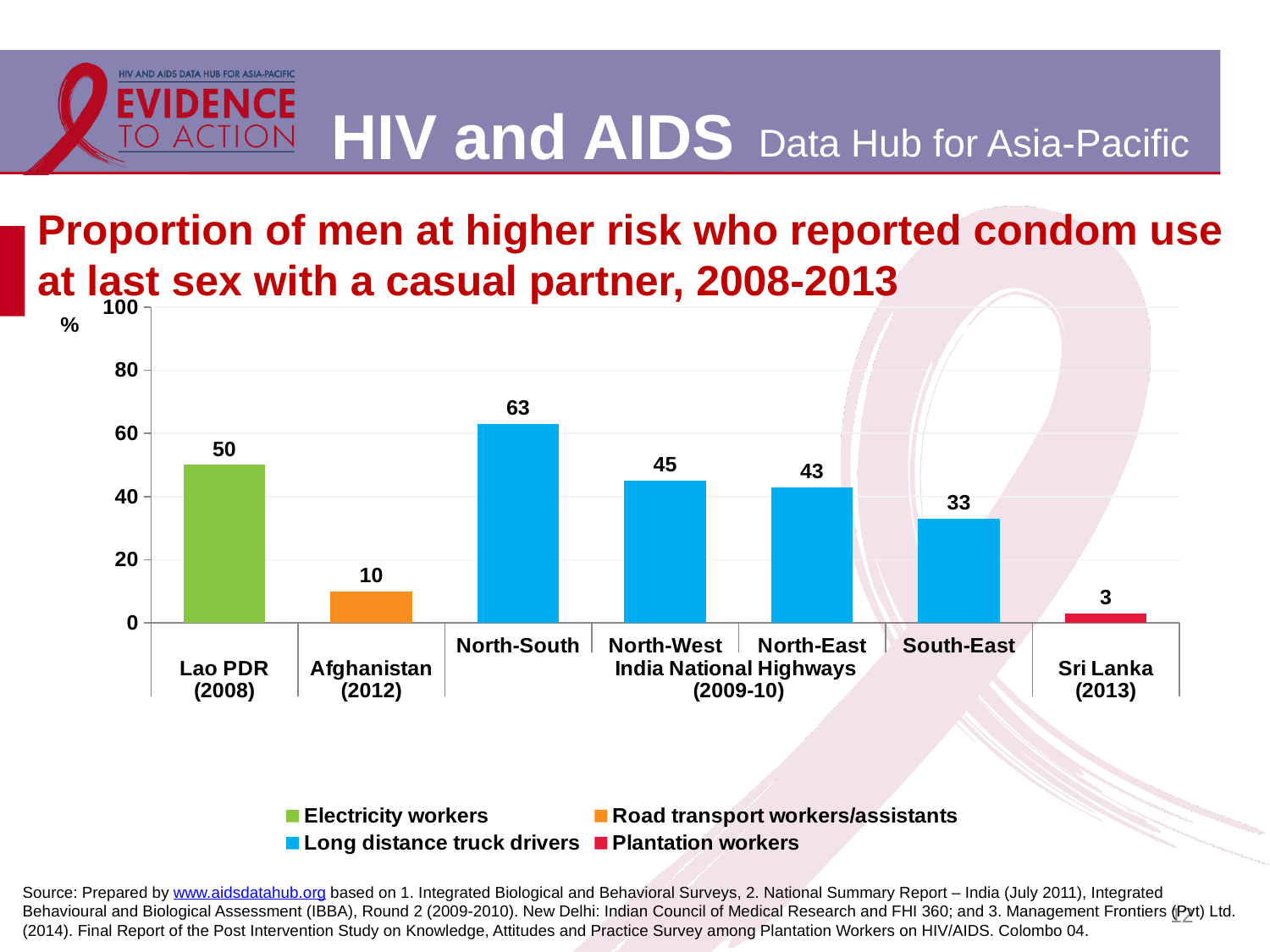
Which bar has the lowest value? Sri Lanka (2013) How many series does the legend list? 4 How many bars are plotted on the chart? 7 Which bar has the highest value? North-South (India National Highways) What is the difference between the North-West and North-East values? 2 What is the value for Lao PDR (2008)? 50 Is the value for Afghanistan (2012) greater or less than 20? less What is the value for the North-South highway in India? 63 Which legend series does the Sri Lanka (2013) bar belong to? Plantation workers What is the value for Sri Lanka (2013)? 3 What kind of chart is shown? bar chart Which is larger, the value for Lao PDR (2008) or the value for South-East? Lao PDR (2008)